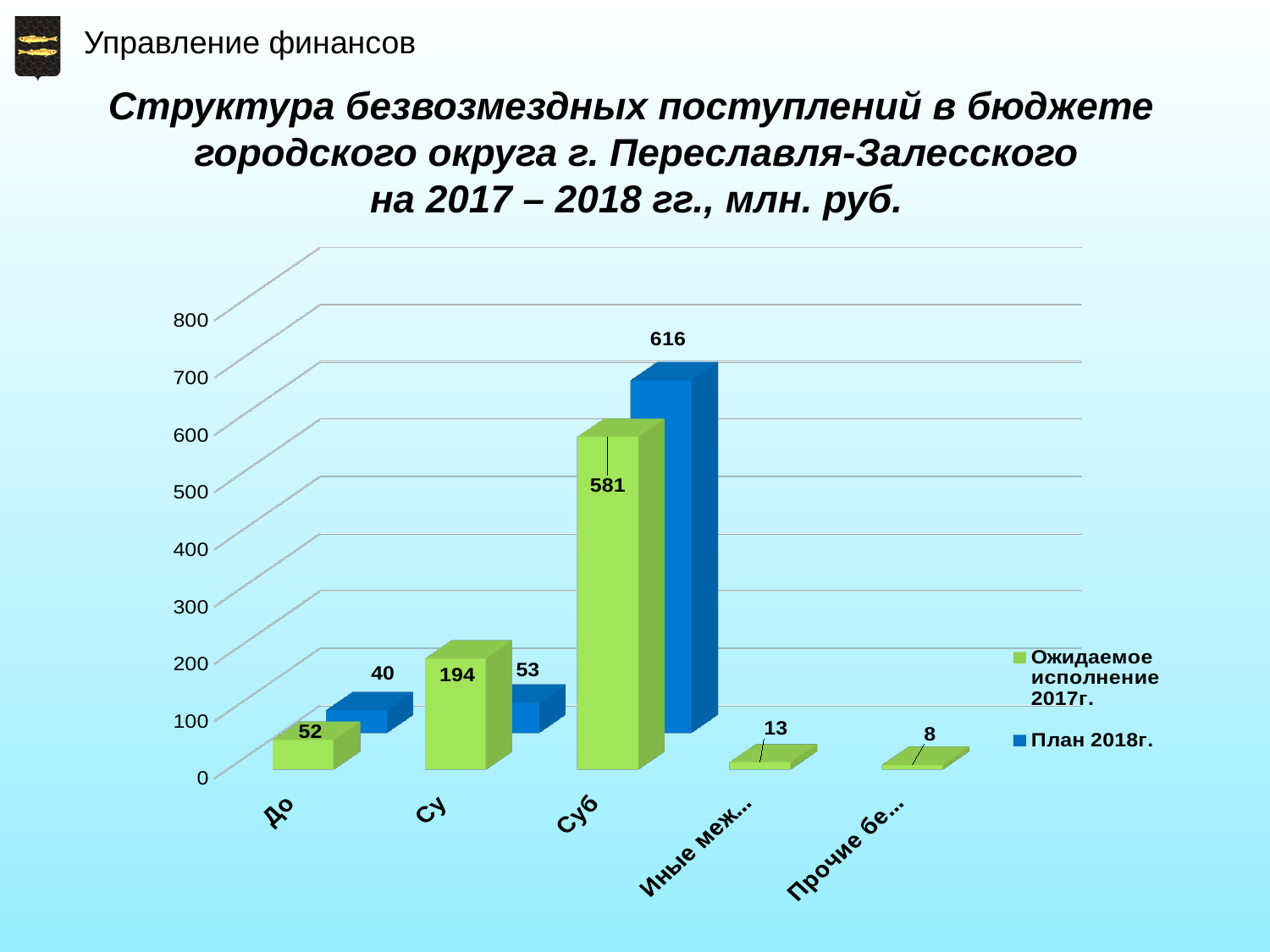
Which category has the highest value for 'Ожидаемое исполнение 2017г.'? Суб What is the value of 'План 2018г.' for the category 'До'? 40 What is the value of 'План 2018г.' for the category 'Суб'? 616 What is the value of 'Ожидаемое исполнение 2017г.' for the category 'Су'? 194 What is the value of 'Ожидаемое исполнение 2017г.' for the category 'Суб'? 581 How many series does the legend list? 2 How many categories are shown on the x axis? 5 Which category has the lowest value for 'Ожидаемое исполнение 2017г.'? Прочие бе... For the category 'Су', which is larger: 'Ожидаемое исполнение 2017г.' or 'План 2018г.'? Ожидаемое исполнение 2017г. What is the difference between 'План 2018г.' and 'Ожидаемое исполнение 2017г.' for the category 'Суб'? 35 What kind of chart is shown on the slide? Bar chart What colour are the bars for 'План 2018г.'? Blue